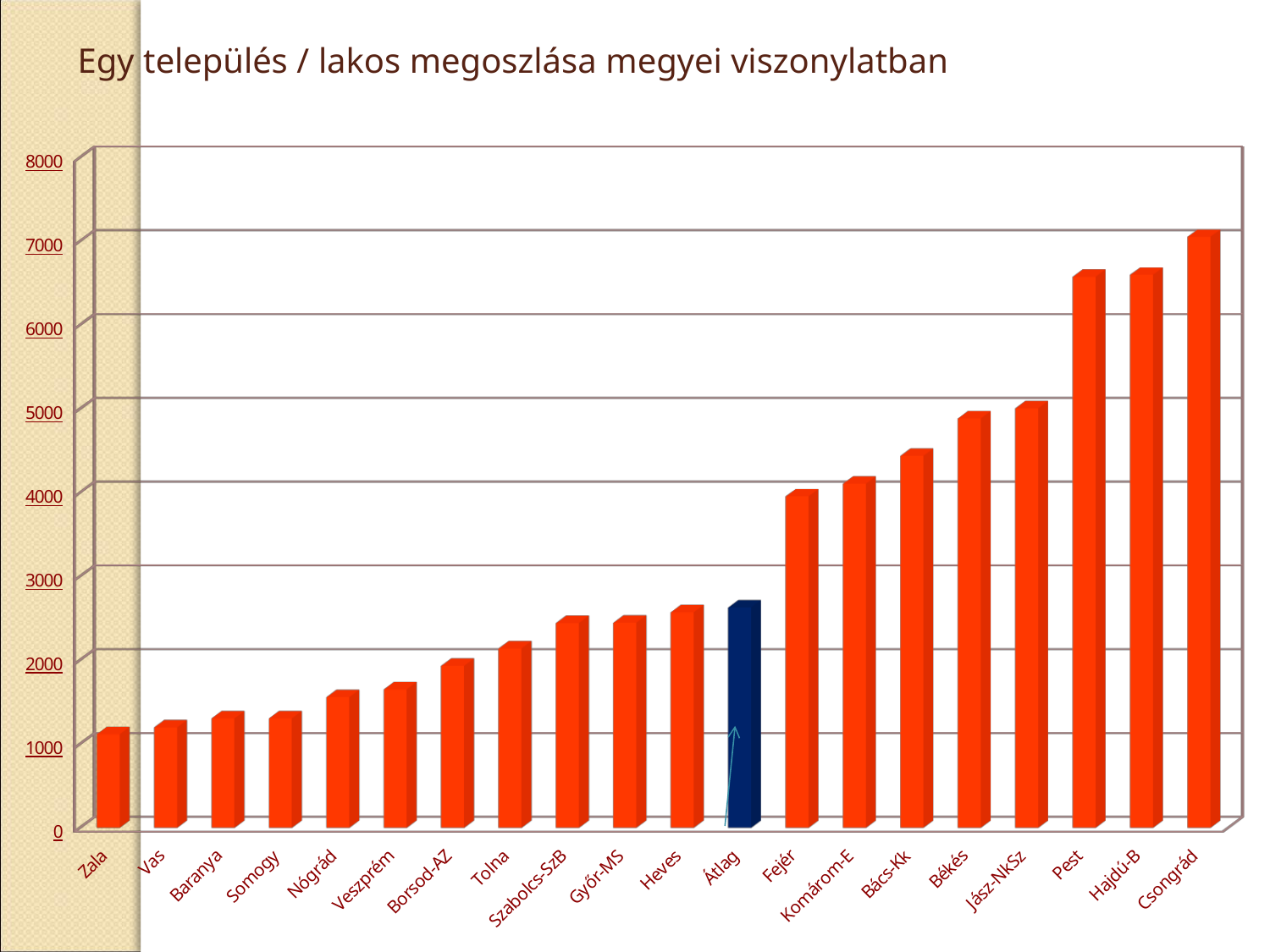
Which is larger, the value for Heves or the value for Fejér? Fejér Is the value for Zala greater or less than 2000? less Do the values generally rise or fall from left to right along the x axis? rise Is the value for Átlag greater or less than 3000? less Is the value for Csongrád greater or less than 6000? greater Which category has the highest value in the chart? Csongrád Which is larger, the value for Pest or the value for Csongrád? Csongrád How many categories are shown on the x axis of the chart? 20 What kind of chart is shown on the slide? bar chart What is the title of the chart? Egy település / lakos megoszlása megyei viszonylatban Which category's bar is coloured dark blue instead of orange-red? Átlag